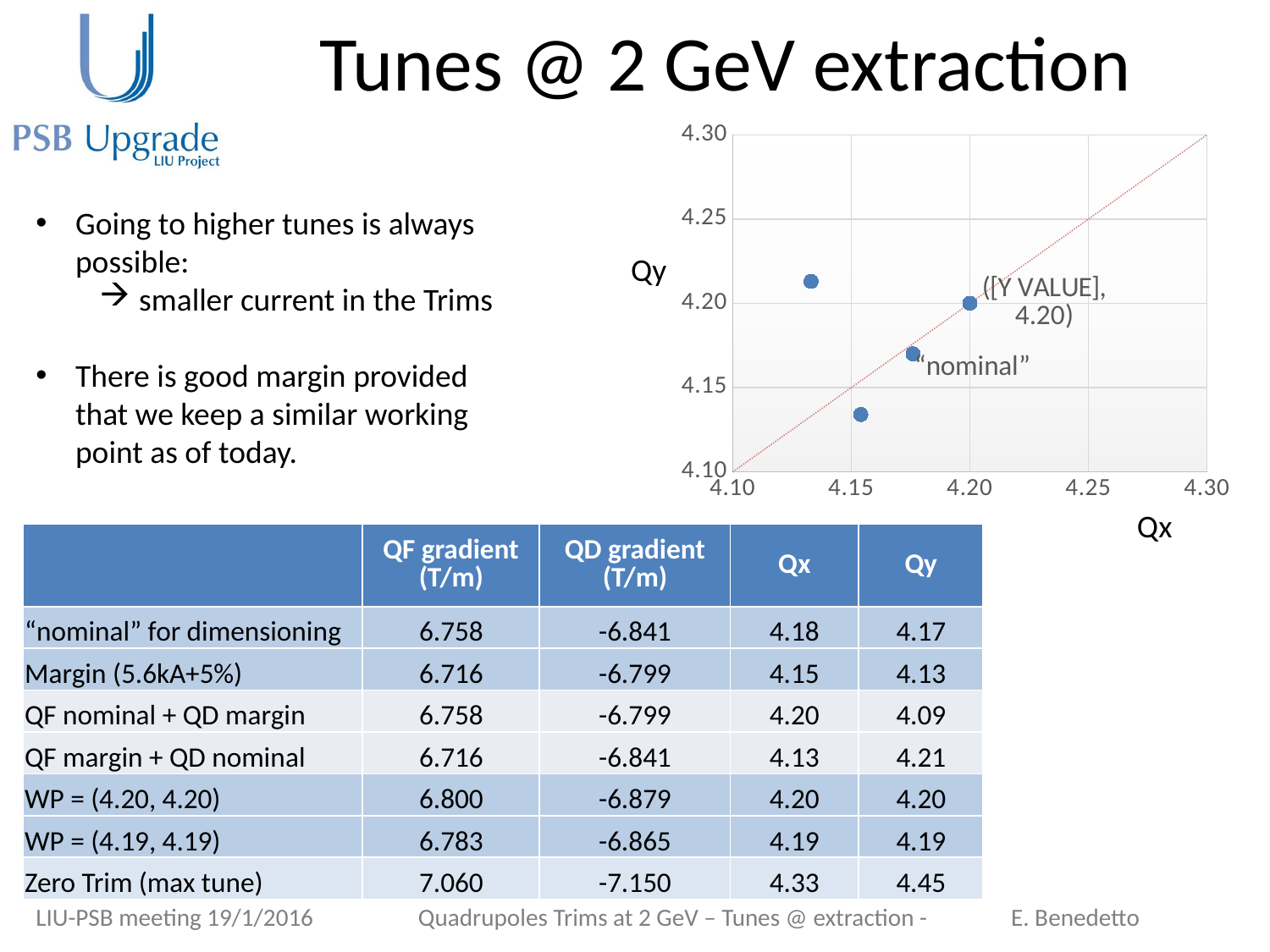
What kind of chart is shown on the slide? scatter chart What is the highest value shown on the Qx axis of the chart? 4.30 Which point has the lower Qy value: the point labelled "nominal" or the point directly below it near Qx 4.15? the point near Qx 4.15 Which point has the higher Qy value: the point labelled "nominal" or the point labelled "([Y VALUE], 4.20)"? the point labelled "([Y VALUE], 4.20)" Is the Qx value of the leftmost point on the chart greater or less than 4.15? less Is the Qy value of the lowest point on the chart greater or less than 4.15? less What is the label of the horizontal axis of the chart? Qx Is the Qy value of the leftmost point on the chart greater or less than 4.20? greater How many data points are plotted on the chart? 4 What is the label of the vertical axis of the chart? Qy